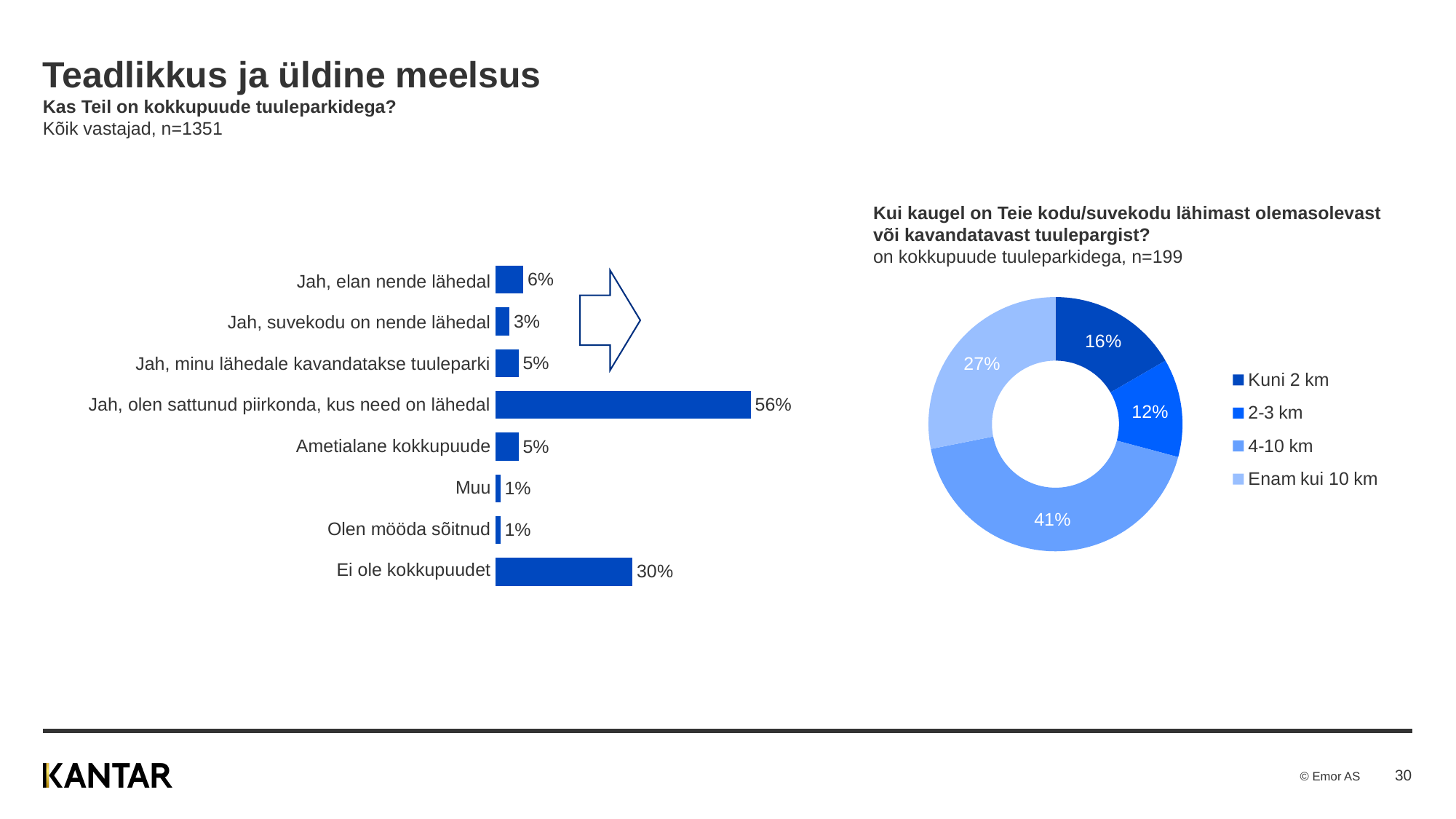
How many entries does the legend of the doughnut chart on the right list? 4 In the bar chart on the left, what is the value for "Ei ole kokkupuudet"? 30% In the bar chart on the left, what is the value for "Jah, suvekodu on nende lähedal"? 3% In the bar chart on the left, what is the value for "Jah, olen sattunud piirkonda, kus need on lähedal"? 56% In the doughnut chart on the right, what share is "Kuni 2 km"? 16% What kind of chart is the chart on the left of the slide? Bar chart In the doughnut chart on the right, which category has the smallest share? 2-3 km In the bar chart on the left, which is larger: "Jah, elan nende lähedal" or "Jah, suvekodu on nende lähedal"? Jah, elan nende lähedal In the bar chart on the left, what is the difference between "Jah, olen sattunud piirkonda, kus need on lähedal" and "Ei ole kokkupuudet"? 26% In the bar chart on the left, which category has the highest value? Jah, olen sattunud piirkonda, kus need on lähedal In the doughnut chart on the right, what share is "4-10 km"? 41% How many categories does the bar chart on the left show? 8